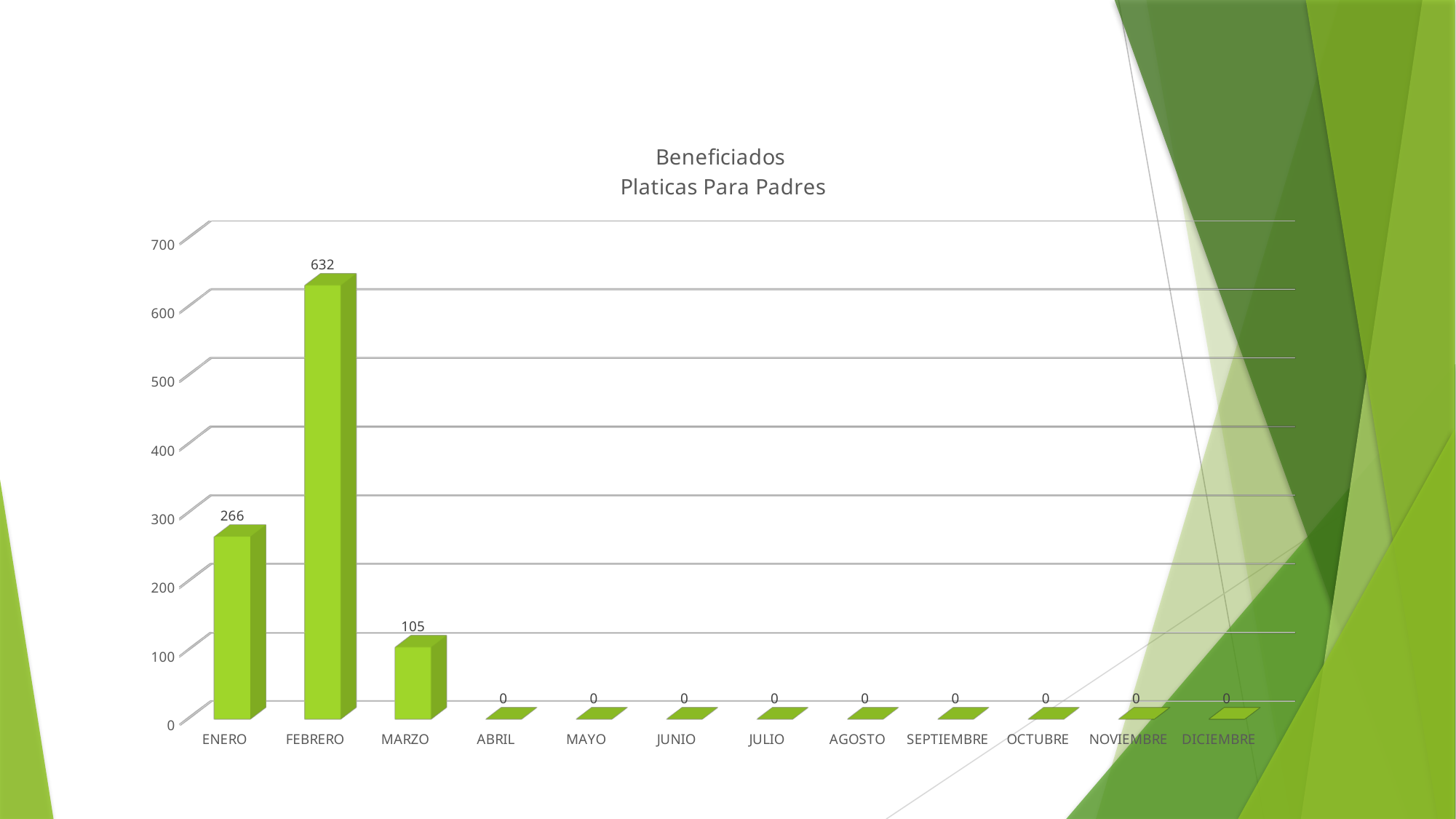
What kind of chart is shown? bar chart Which is larger, the value for ENERO or the value for MARZO? ENERO What is the difference between the values for FEBRERO and ENERO? 366 Which month has the highest value? FEBRERO Is the value for FEBRERO greater or less than 600? greater What is the value for ABRIL? 0 How many months are shown on the x axis? 12 What is the value for FEBRERO? 632 What is the difference between the values for ENERO and MARZO? 161 What is the value for ENERO? 266 What is the value for MARZO? 105 What is the title of the chart? Beneficiados Platicas Para Padres